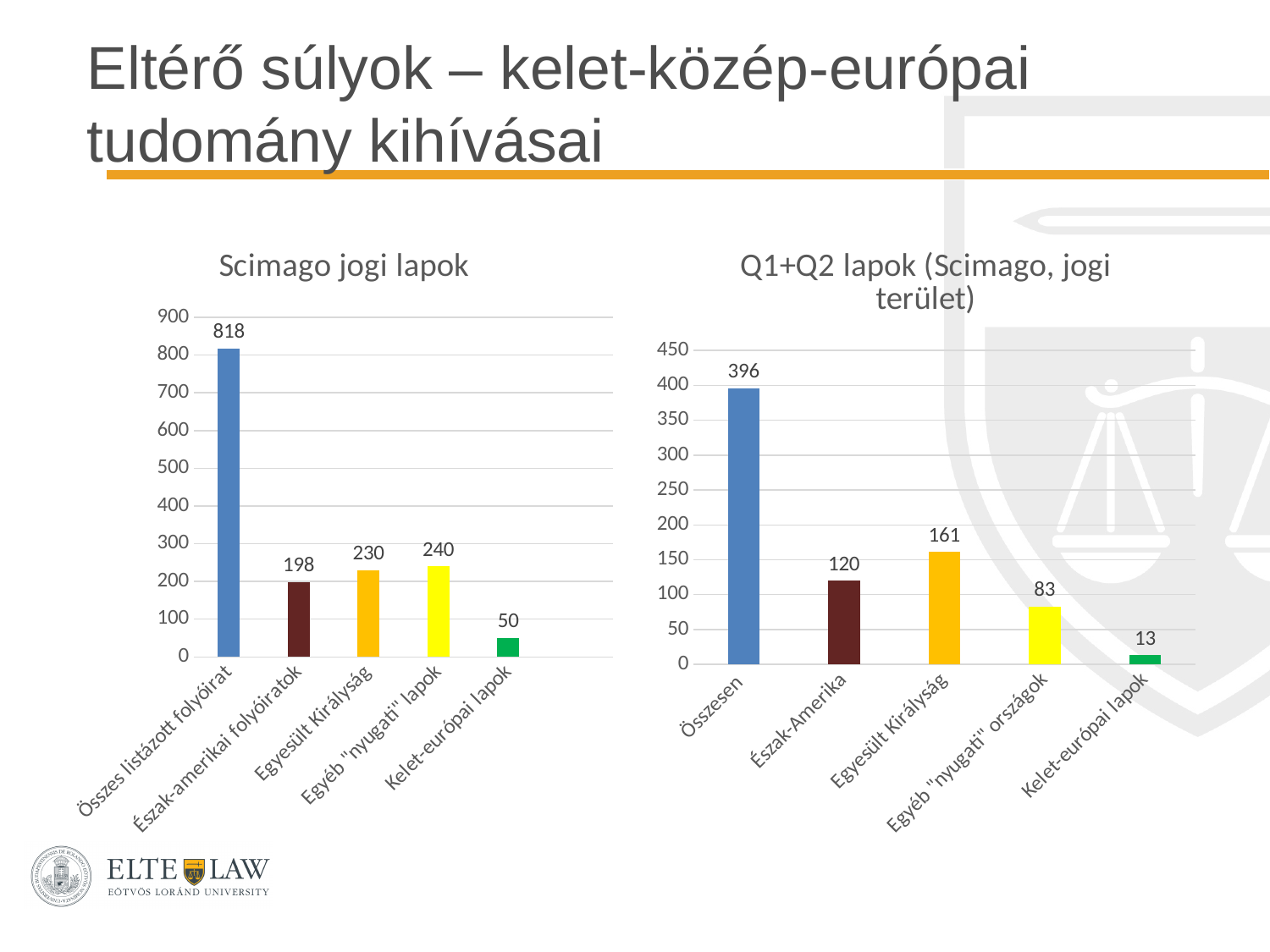
In the 'Scimago jogi lapok' chart, which is larger: Egyesült Királyság or Észak-amerikai folyóiratok? Egyesült Királyság In the 'Q1+Q2 lapok (Scimago, jogi terület)' chart, what is the value for Egyesült Királyság? 161 In the 'Scimago jogi lapok' chart, which category has the lowest value? Kelet-európai lapok In the 'Scimago jogi lapok' chart, what is the value for Kelet-európai lapok? 50 What type of chart is the 'Scimago jogi lapok' chart? Bar chart In the 'Scimago jogi lapok' chart, what is the value for Összes listázott folyóirat? 818 In the 'Q1+Q2 lapok (Scimago, jogi terület)' chart, what is the difference between Észak-Amerika and Egyéb "nyugati" országok? 37 In the 'Q1+Q2 lapok (Scimago, jogi terület)' chart, which category has the highest value? Összesen In the 'Scimago jogi lapok' chart, what is the difference between Egyéb "nyugati" lapok and Észak-amerikai folyóiratok? 42 How many categories are shown in the 'Q1+Q2 lapok (Scimago, jogi terület)' chart? 5 In the 'Scimago jogi lapok' chart, what colour is the bar for Kelet-európai lapok? Green In the 'Q1+Q2 lapok (Scimago, jogi terület)' chart, what is the value for Kelet-európai lapok? 13